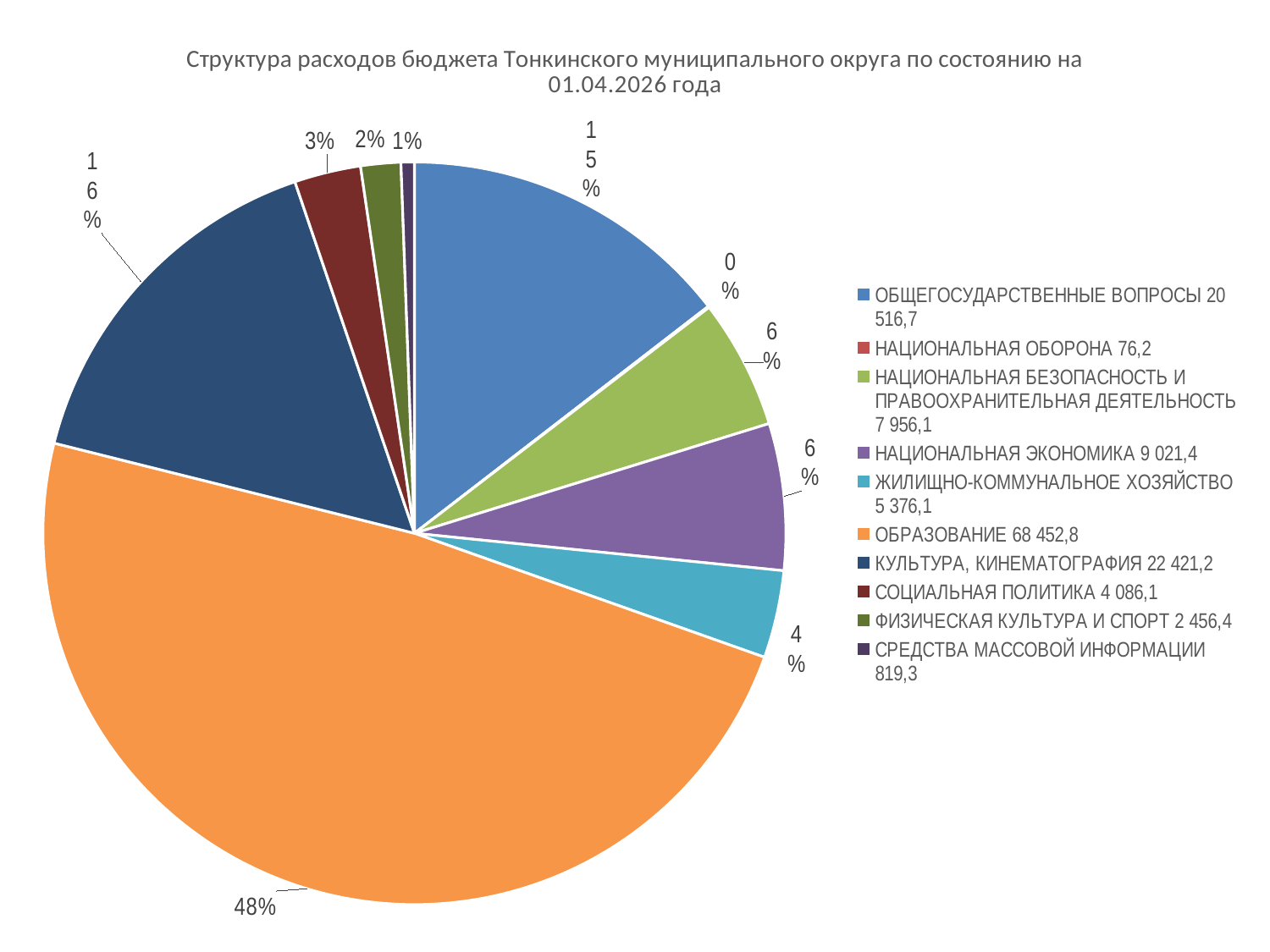
Which category has the smallest share of the pie, labelled 0%? НАЦИОНАЛЬНАЯ ОБОРОНА What share of the pie does ОБРАЗОВАНИЕ take? 48% Which is larger, the share for КУЛЬТУРА, КИНЕМАТОГРАФИЯ or the share for СОЦИАЛЬНАЯ ПОЛИТИКА? КУЛЬТУРА, КИНЕМАТОГРАФИЯ What kind of chart is shown on the slide? pie chart What value is shown in the legend for ОБРАЗОВАНИЕ? 68 452,8 What value is shown in the legend for СРЕДСТВА МАССОВОЙ ИНФОРМАЦИИ? 819,3 What share of the pie does ОБЩЕГОСУДАРСТВЕННЫЕ ВОПРОСЫ take? 15% By how many percentage points does the share of ОБРАЗОВАНИЕ exceed the share of КУЛЬТУРА, КИНЕМАТОГРАФИЯ? 32 What share of the pie does ЖИЛИЩНО-КОММУНАЛЬНОЕ ХОЗЯЙСТВО take? 4% Which category has the largest share of the pie? ОБРАЗОВАНИЕ How many categories does the legend of the pie chart list? 10